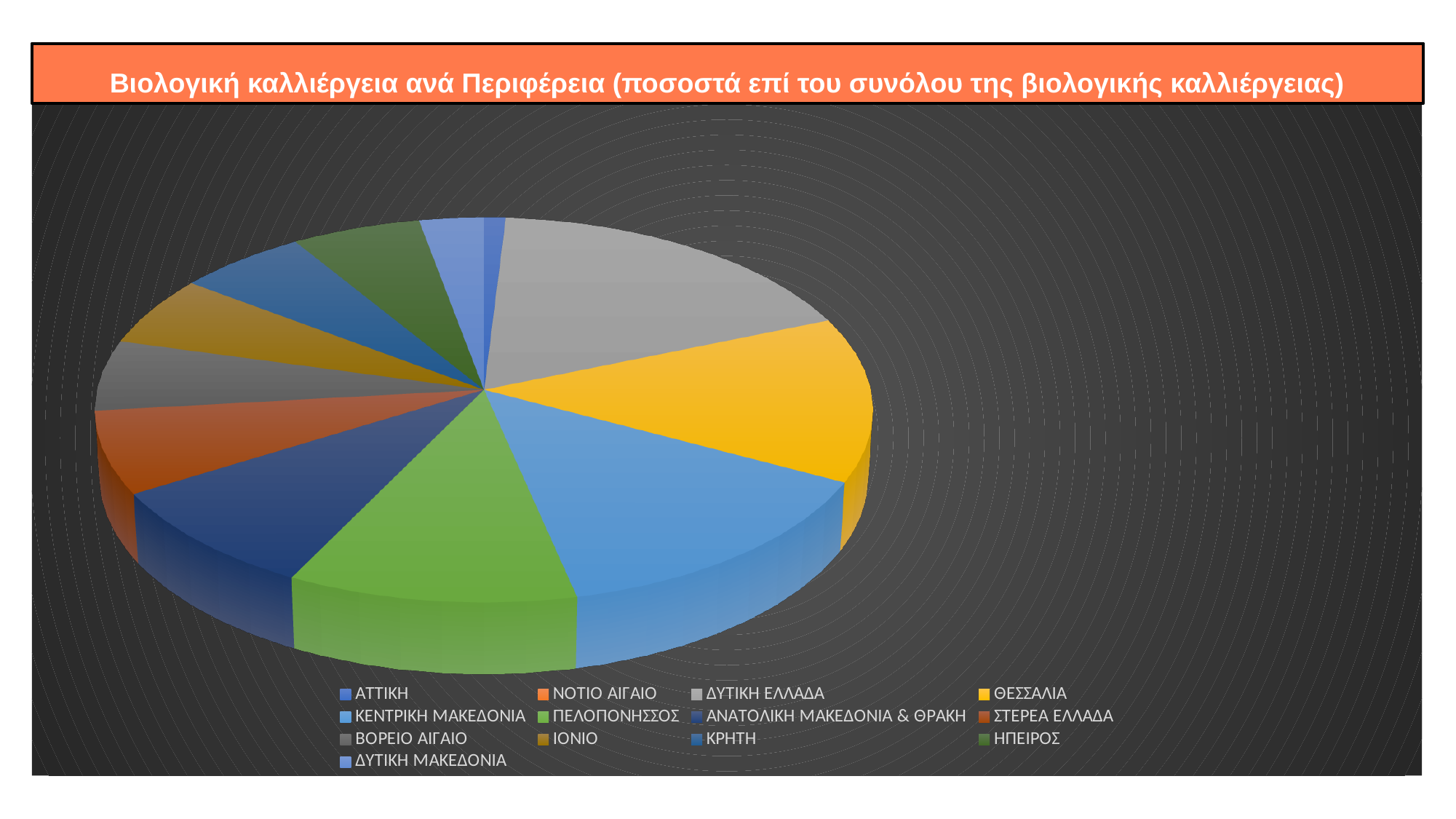
Which slice is larger, ΠΕΛΟΠΟΝΝΗΣΟΣ or ΗΠΕΙΡΟΣ? ΠΕΛΟΠΟΝΗΣΣΟΣ What kind of chart is shown on the slide? Pie chart Which slice is larger, ΔΥΤΙΚΗ ΕΛΛΑΔΑ or ΑΤΤΙΚΗ? ΔΥΤΙΚΗ ΕΛΛΑΔΑ What colour represents ΘΕΣΣΑΛΙΑ in the legend? Yellow Which slice is larger, ΘΕΣΣΑΛΙΑ or ΙΟΝΙΟ? ΘΕΣΣΑΛΙΑ How many regions (categories) does the pie chart's legend list? 13 What is the title of the chart? Βιολογική καλλιέργεια ανά Περιφέρεια (ποσοστά επί του συνόλου της βιολογικής καλλιέργειας)